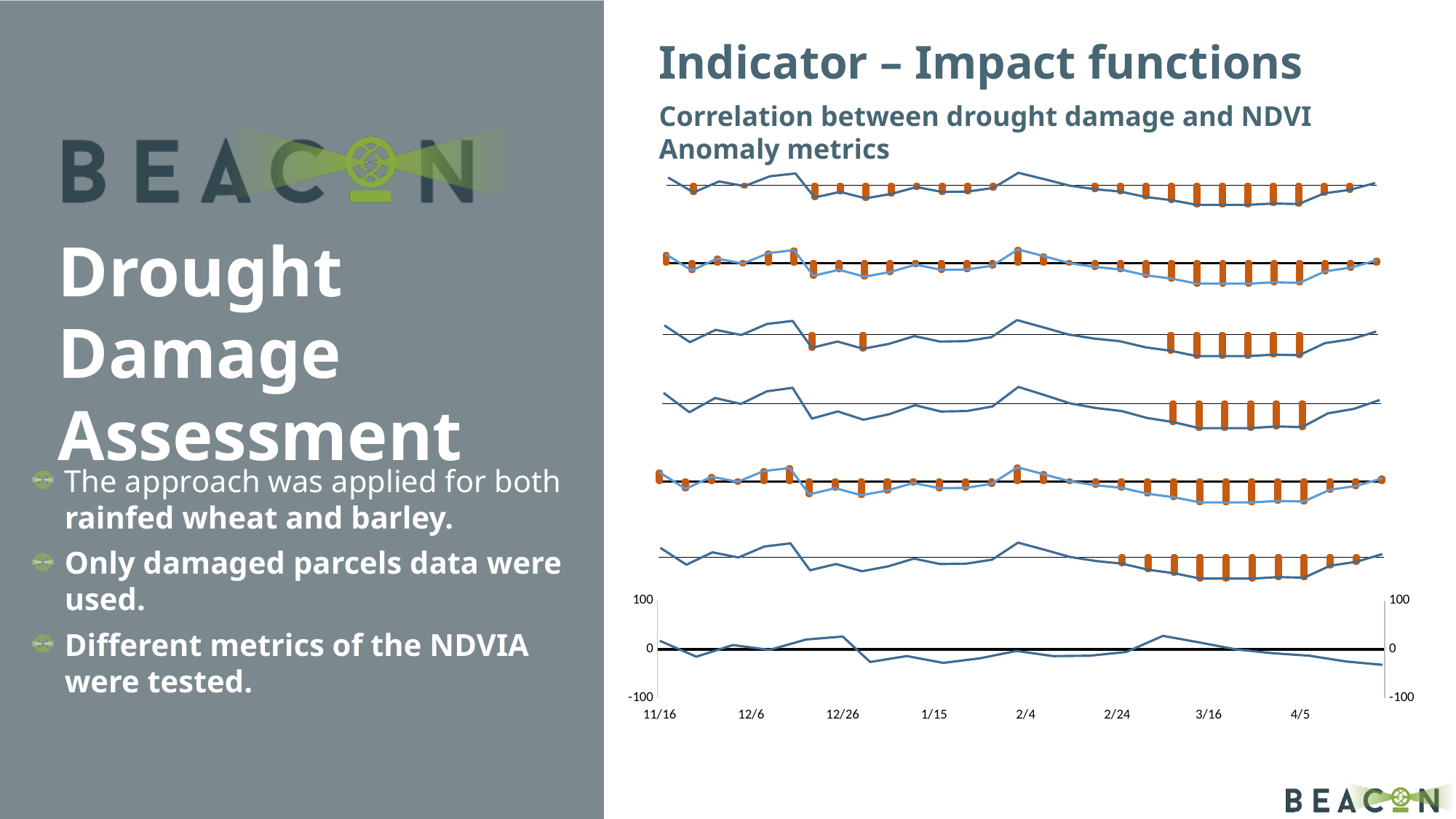
What kind of chart is the bottom chart with the -100 to 100 axis? line chart What is the lowest value shown on the y axis of the bottom chart? -100 In the bottom chart, is the value at 1/15 greater or less than 0? less What is the highest value shown on the y axis of the bottom chart? 100 In the bottom chart, is the value at 4/5 greater or less than 0? less How many separate line charts are stacked on the right side of the slide? 7 What is the last date label on the x axis of the bottom chart? 4/5 In the bottom chart, does the line rise or fall between 3/16 and the right end of the chart? fall What colour are the vertical bars drawn on the upper line charts? orange What is the first date label on the x axis of the bottom chart? 11/16 What is the subtitle printed above the charts? Correlation between drought damage and NDVI Anomaly metrics How many date labels are shown on the x axis of the bottom chart? 8